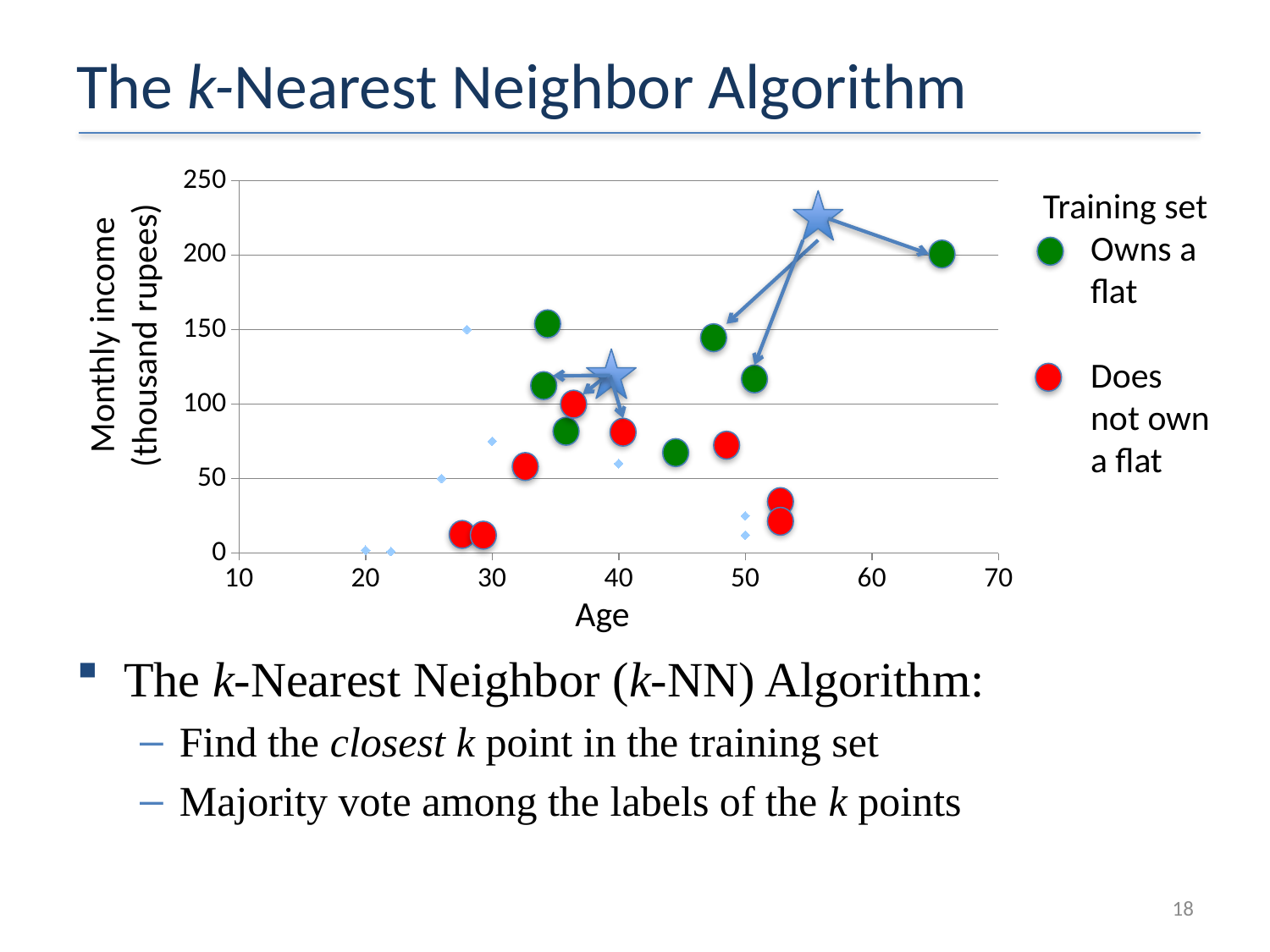
Is the monthly income of the red points near age 28-30 greater or less than 50? less Is the monthly income of the lower star (near age 39) greater or less than 100? greater What is the highest value shown on the y axis of the chart? 250 Is the monthly income of the upper star (near age 56) greater or less than 200? greater Which legend category do the green points represent? Owns a flat How many categories does the legend of the chart list under "Training set"? 2 What is the label of the y axis of the chart? Monthly income (thousand rupees) What kind of chart is shown on the slide? scatter chart What is the label of the x axis of the chart? Age Which legend category do the red points represent? Does not own a flat Which category, "Owns a flat" or "Does not own a flat", has the training point with the highest monthly income? Owns a flat